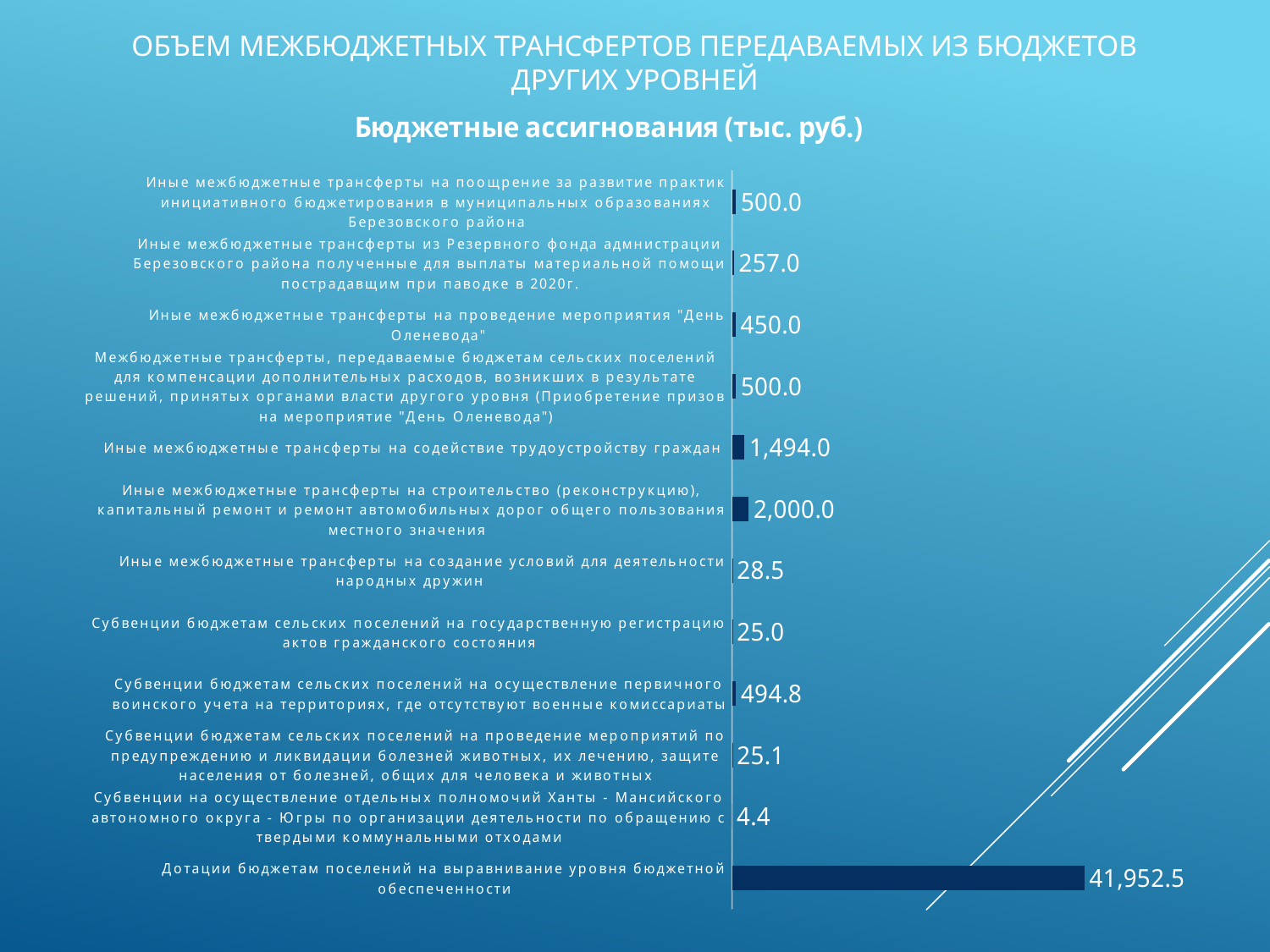
Which is larger: the value for "Иные межбюджетные трансферты из Резервного фонда администрации Березовского района..." or the value for "Иные межбюджетные трансферты на проведение мероприятия "День Оленевода""? Иные межбюджетные трансферты на проведение мероприятия "День Оленевода" What is the value for "Иные межбюджетные трансферты на содействие трудоустройству граждан"? 1,494.0 How many categories are shown in the chart? 12 What is the value for "Дотации бюджетам поселений на выравнивание уровня бюджетной обеспеченности"? 41,952.5 Which category has the highest value? Дотации бюджетам поселений на выравнивание уровня бюджетной обеспеченности What is the value for "Иные межбюджетные трансферты на проведение мероприятия "День Оленевода""? 450.0 What kind of chart is shown on the slide? Bar chart What is the value for "Иные межбюджетные трансферты на создание условий для деятельности народных дружин"? 28.5 What is the difference between the value for "Иные межбюджетные трансферты на строительство (реконструкцию), капитальный ремонт и ремонт автомобильных дорог общего пользования местного значения" and the value for "Иные межбюджетные трансферты на содействие трудоустройству граждан"? 506.0 Which category has the lowest value? Субвенции на осуществление отдельных полномочий Ханты - Мансийского автономного округа - Югры по организации деятельности по обращению с твердыми коммунальными отходами What is the value for "Субвенции бюджетам сельских поселений на осуществление первичного воинского учета на территориях, где отсутствуют военные комиссариаты"? 494.8 What is the title of the chart? Бюджетные ассигнования (тыс. руб.)